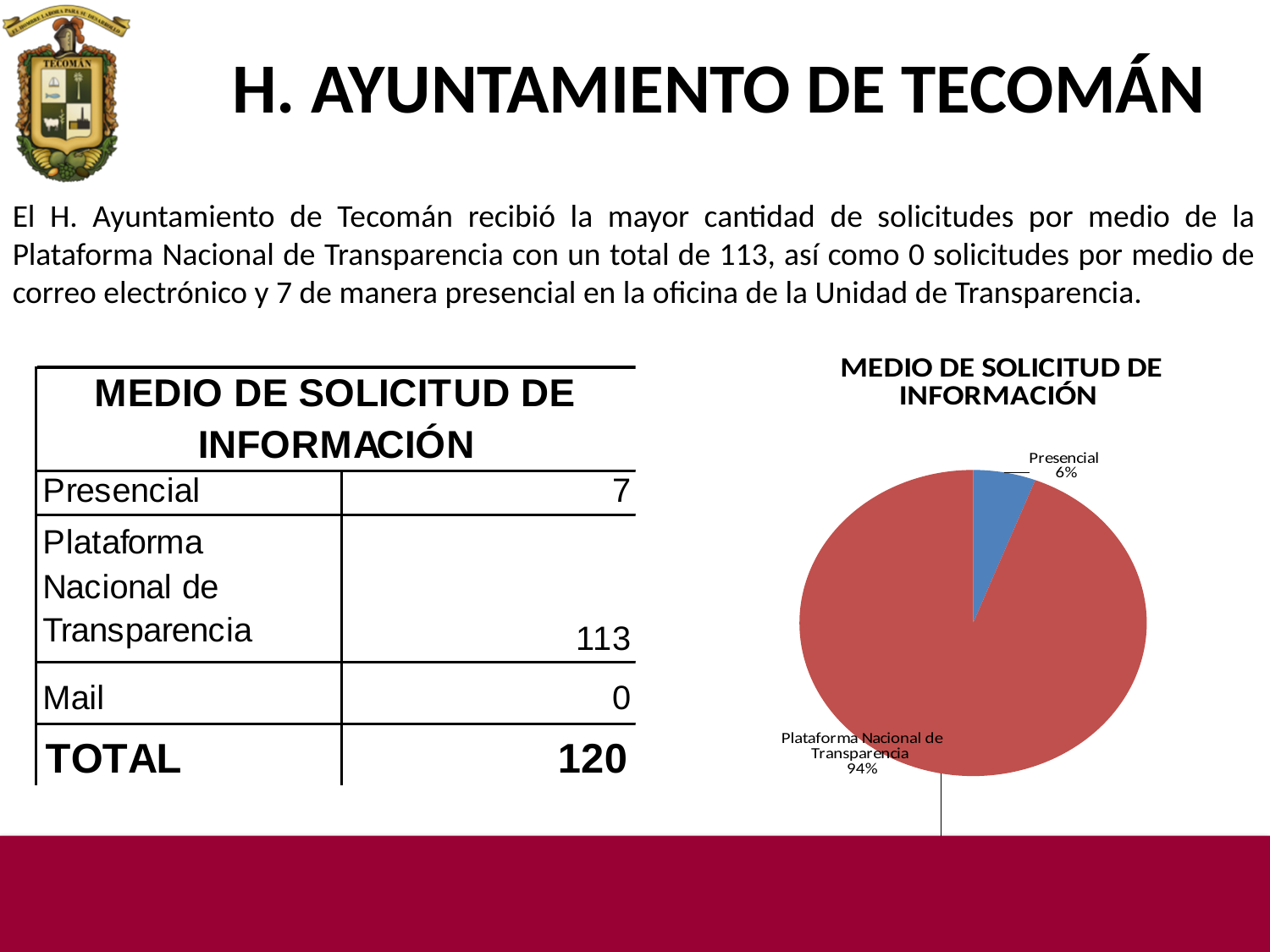
Is the share for Plataforma Nacional de Transparencia in the pie chart greater or less than 50%? greater What kind of chart is shown on the slide? pie chart What colour is the Presencial slice in the pie chart? blue How many slices in the pie chart have a percentage label? 2 Is the share for Presencial in the pie chart greater or less than 10%? less By how many percentage points does the Plataforma Nacional de Transparencia share exceed the Presencial share in the pie chart? 88 Which labelled category has the smallest slice in the pie chart? Presencial In the pie chart, which slice is larger: Presencial or Plataforma Nacional de Transparencia? Plataforma Nacional de Transparencia What is the title of the pie chart? MEDIO DE SOLICITUD DE INFORMACIÓN In the pie chart, what share is shown for Plataforma Nacional de Transparencia? 94% Which category has the largest slice in the pie chart? Plataforma Nacional de Transparencia In the pie chart, what share is shown for Presencial? 6%